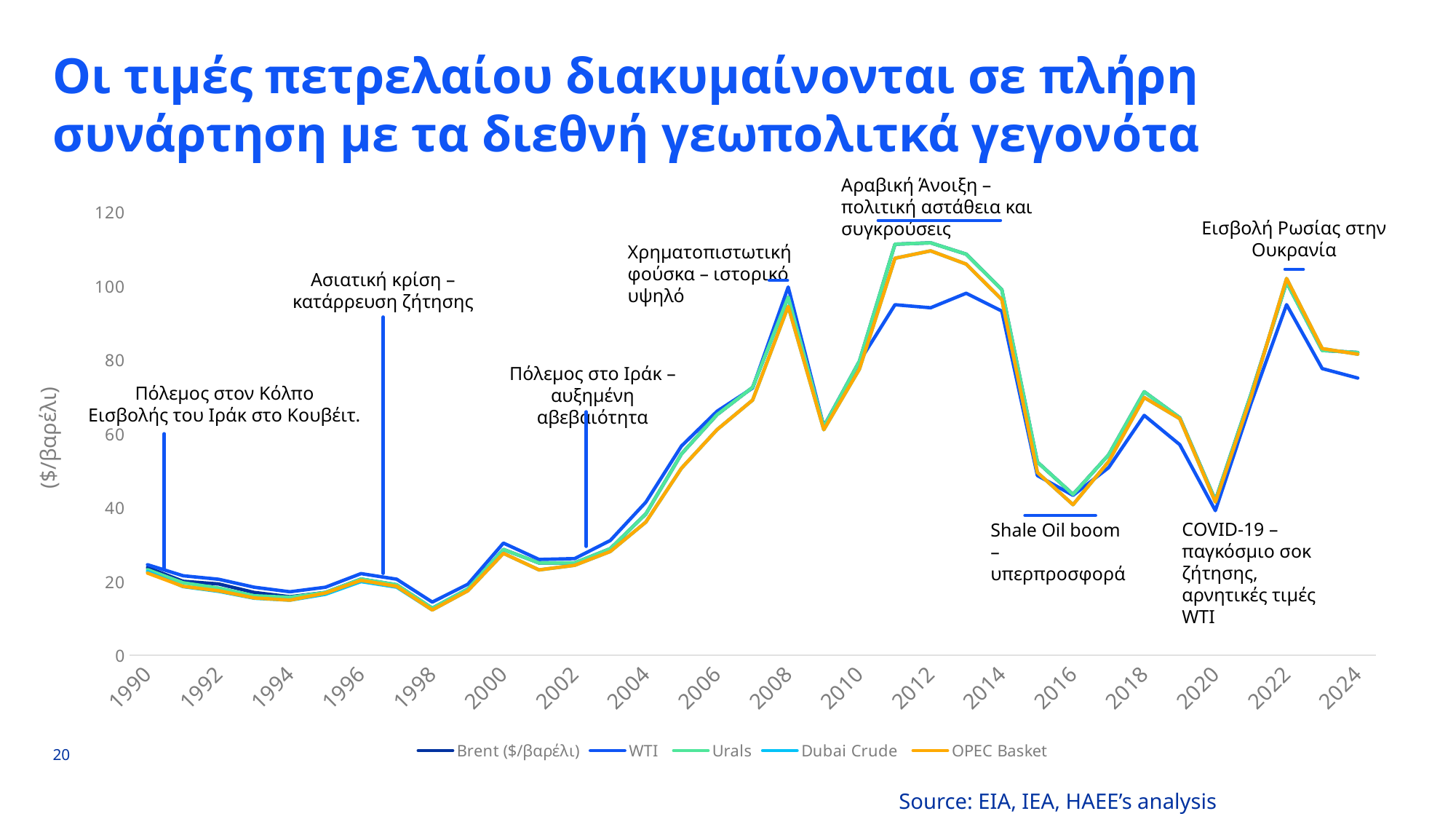
Is the value for WTI in 2020 greater or less than 60? less Do oil prices rise or fall between 1998 and 2008? rise What is the label on the vertical axis? ($/βαρέλι) Is the value for Urals in 2012 greater or less than 100? greater How many series does the legend list? 5 Which series are listed in the legend? Brent ($/βαρέλι), WTI, Urals, Dubai Crude, OPEC Basket In which year do the oil prices reach their lowest point on the chart? 1998 What kind of chart is shown on the slide? line chart How many year labels are shown on the x axis? 18 Which is larger, the Brent price in 2008 or the Brent price in 2020? 2008 Is the value for Brent in 1998 greater or less than 20? less